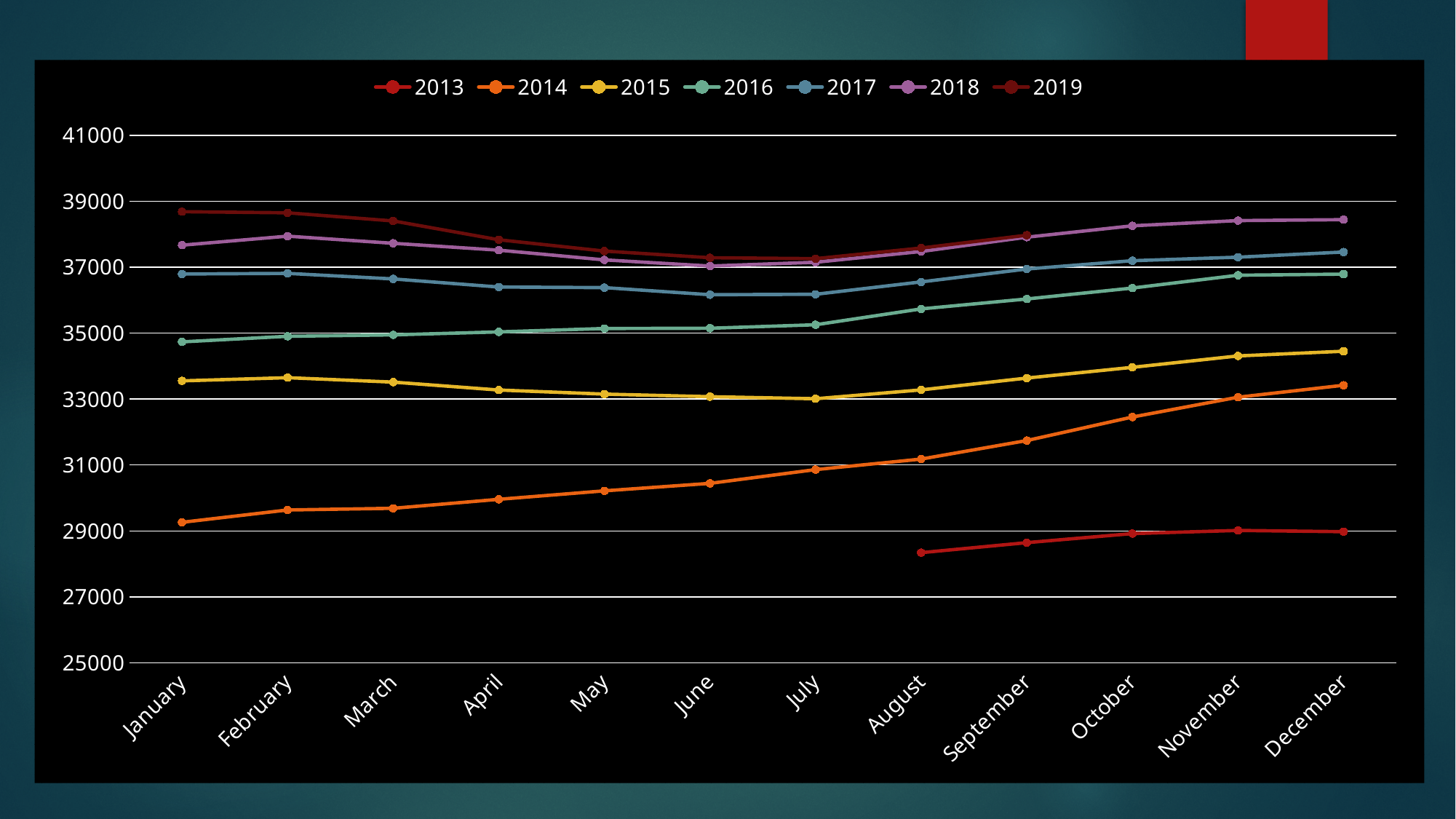
Is the value for 2013 in August greater or less than 29000? less In December, which series has the larger value, 2017 or 2018? 2018 How many series does the legend list? 7 Which series has the highest value in January? 2019 Do the values for the 2019 series rise or fall from January to July? fall Is the value for 2016 in December greater or less than 35000? greater Is the value for 2014 in January greater or less than 31000? less How many months are shown along the x axis? 12 Which series has the lowest value in December? 2013 What kind of chart is shown on the slide? line chart Do the values for the 2014 series rise or fall from January to December? rise